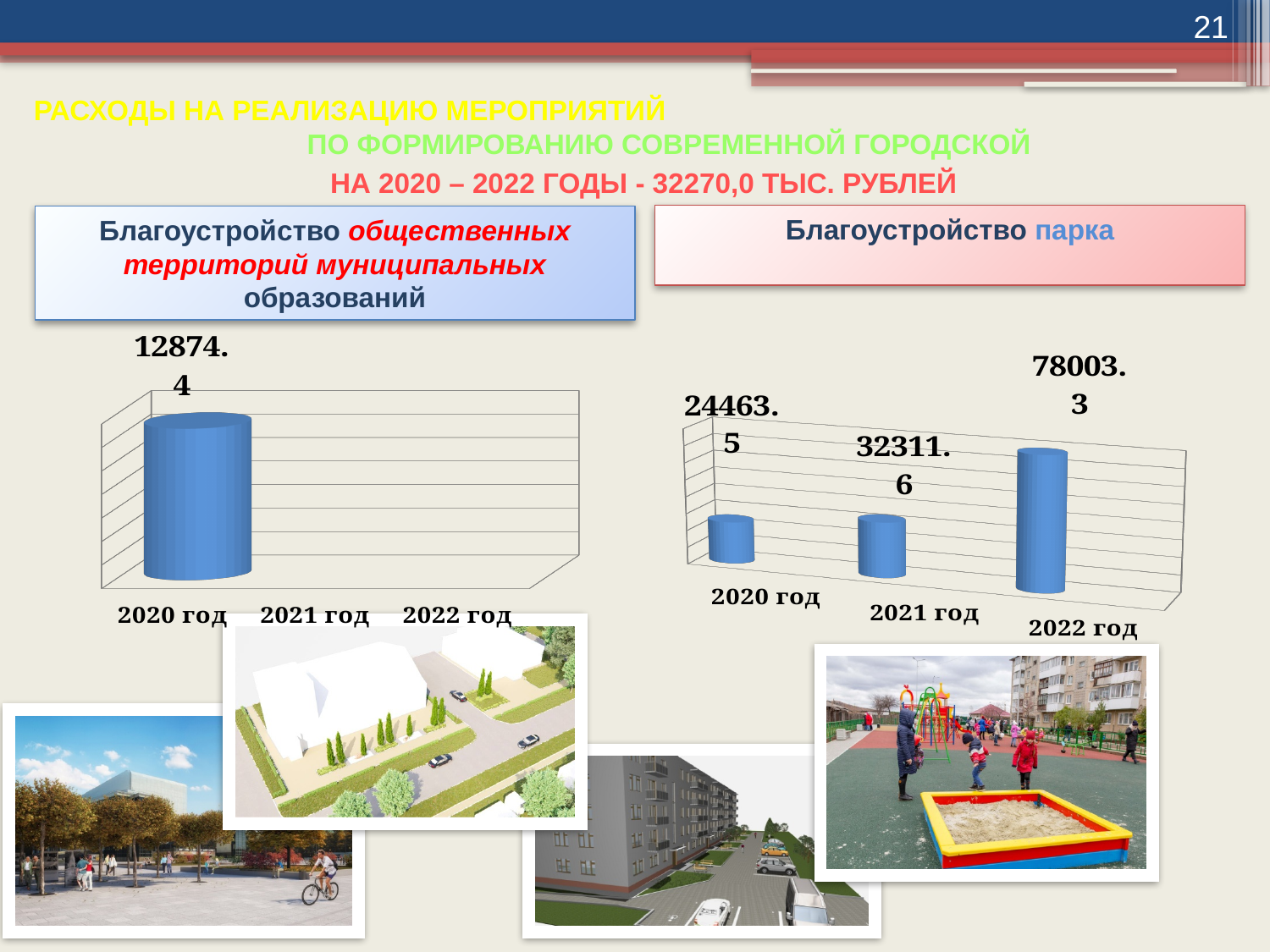
On the chart for 'Благоустройство парка', what is the difference between the values for 2021 год and 2020 год? 7848.1 On the chart for 'Благоустройство парка', which year has the lowest value? 2020 год On the chart for 'Благоустройство парка', what is the value for 2020 год? 24463.5 How many year categories are shown on the x axis of the chart for 'Благоустройство парка'? 3 On the chart for 'Благоустройство парка', what is the difference between the values for 2022 год and 2020 год? 53539.8 On the chart for 'Благоустройство парка', what is the value for 2022 год? 78003.3 On the chart for 'Благоустройство парка', which year has the highest value? 2022 год On the chart for 'Благоустройство парка', do the values rise or fall from 2020 год to 2022 год? rise What kind of chart is used for 'Благоустройство парка'? bar chart On the chart for 'Благоустройство парка', which is larger, the value for 2021 год or 2022 год? 2022 год On the chart for 'Благоустройство парка', what is the value for 2021 год? 32311.6 On the left chart ('Благоустройство общественных территорий муниципальных образований'), what is the value for 2020 год? 12874.4